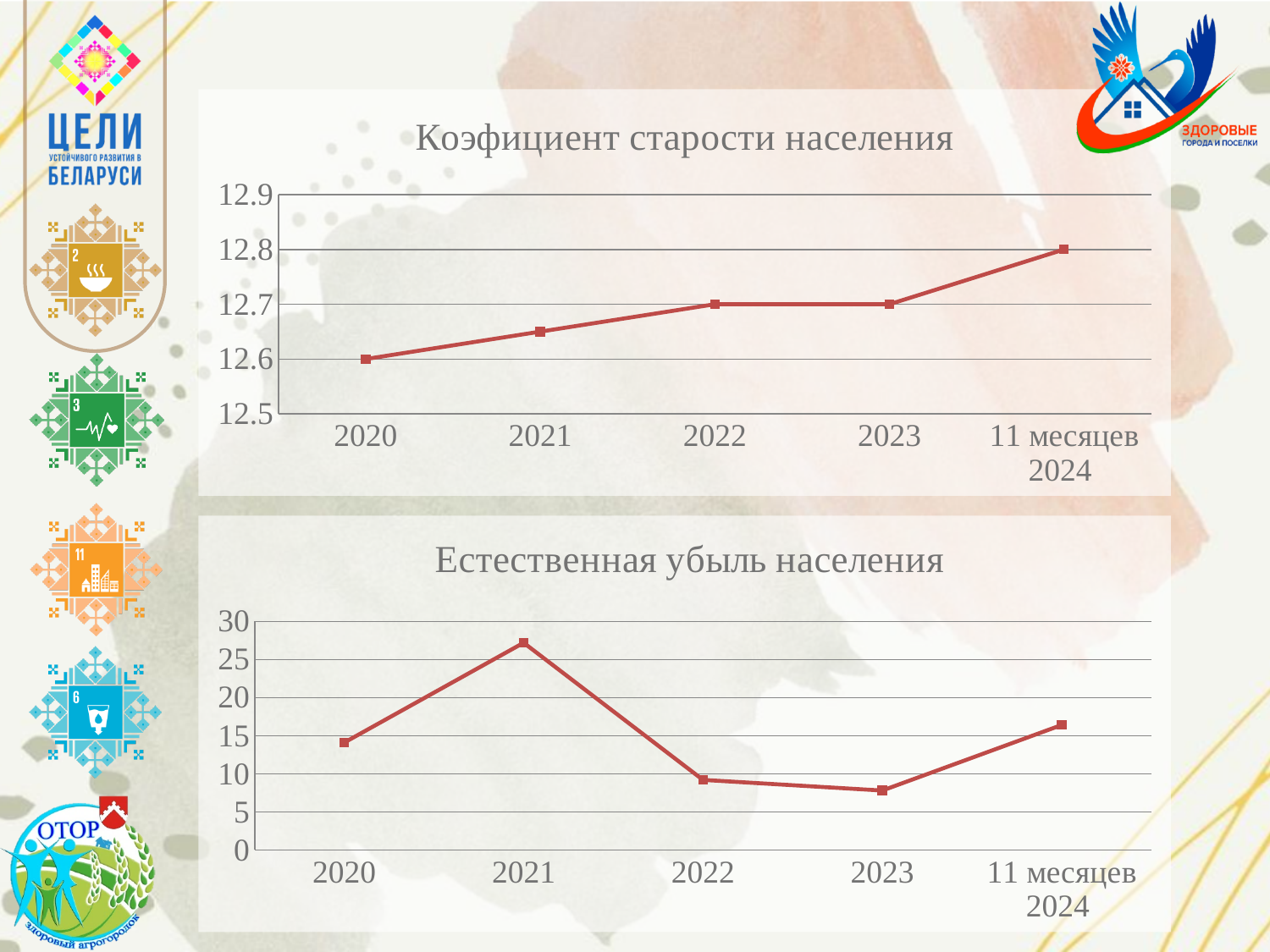
In the chart titled "Естественная убыль населения", which is larger, the value for 2020 or the value for 2022? 2020 In the chart titled "Коэфициент старости населения", which period has the lowest value? 2020 What type of chart is the chart titled "Естественная убыль населения"? line chart In the chart titled "Коэфициент старости населения", is the value for 2021 greater or less than 12.7? less In the chart titled "Естественная убыль населения", which period has the highest value? 2021 In the chart titled "Естественная убыль населения", is the value for 2021 greater or less than 25? greater In the chart titled "Коэфициент старости населения", what is the value for 11 месяцев 2024? 12.8 In the chart titled "Коэфициент старости населения", what is the value for 2022? 12.7 In the chart titled "Коэфициент старости населения", what is the value for 2020? 12.6 In the chart titled "Коэфициент старости населения", do the values generally rise or fall from 2020 to 11 месяцев 2024? rise In the chart titled "Естественная убыль населения", which period has the lowest value? 2023 In the chart titled "Коэфициент старости населения", which period has the highest value? 11 месяцев 2024